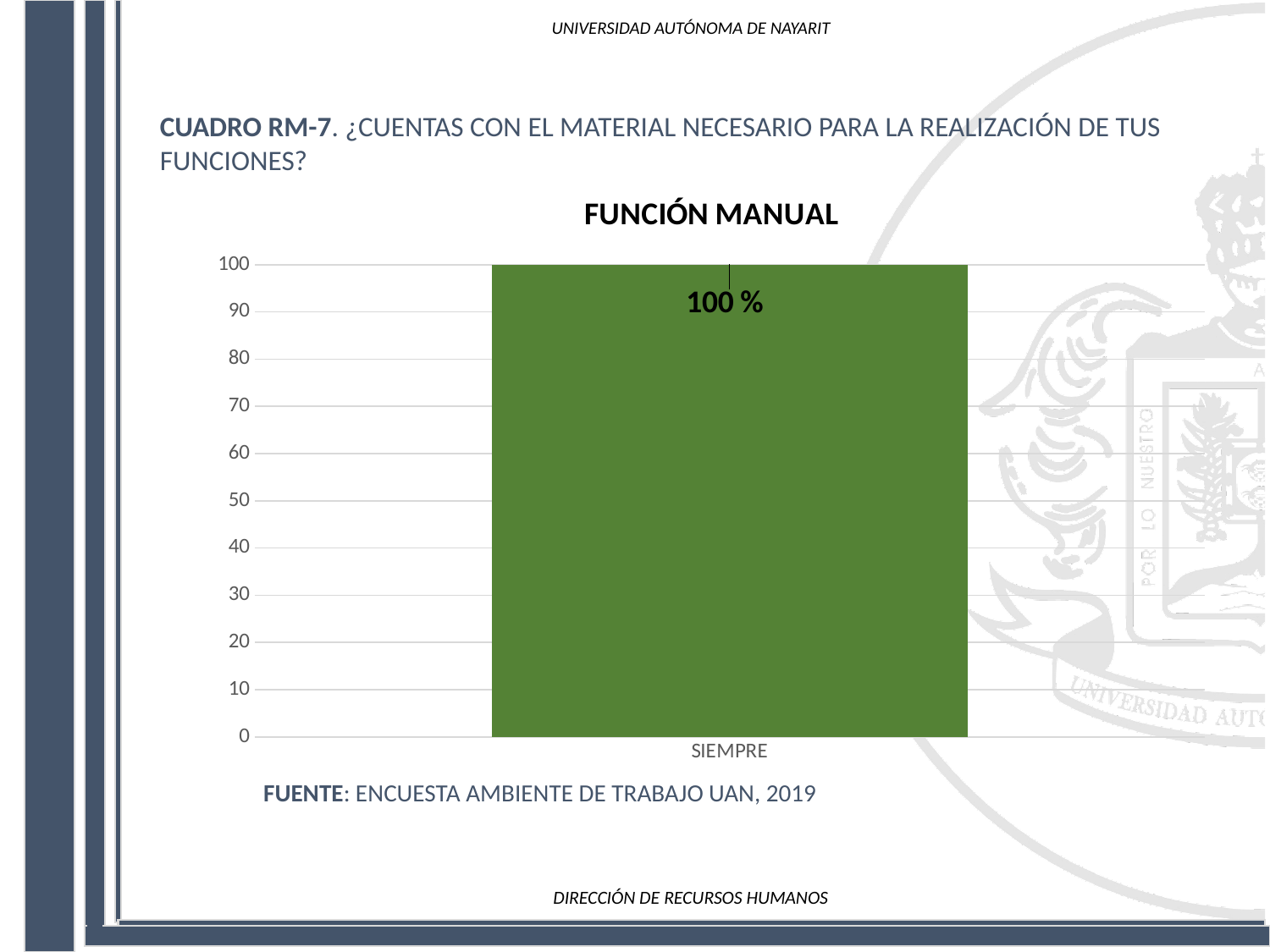
What is the value for SIEMPRE in the FUNCIÓN MANUAL chart? 100 % What is the title of the chart? FUNCIÓN MANUAL Which category has the highest value in the chart? SIEMPRE What is the label of the only category on the x axis? SIEMPRE How many categories are shown on the x axis of the chart? 1 What kind of chart is shown on the slide? bar chart What is the highest value shown on the vertical axis of the chart? 100 Is the value for SIEMPRE greater or less than 50? greater